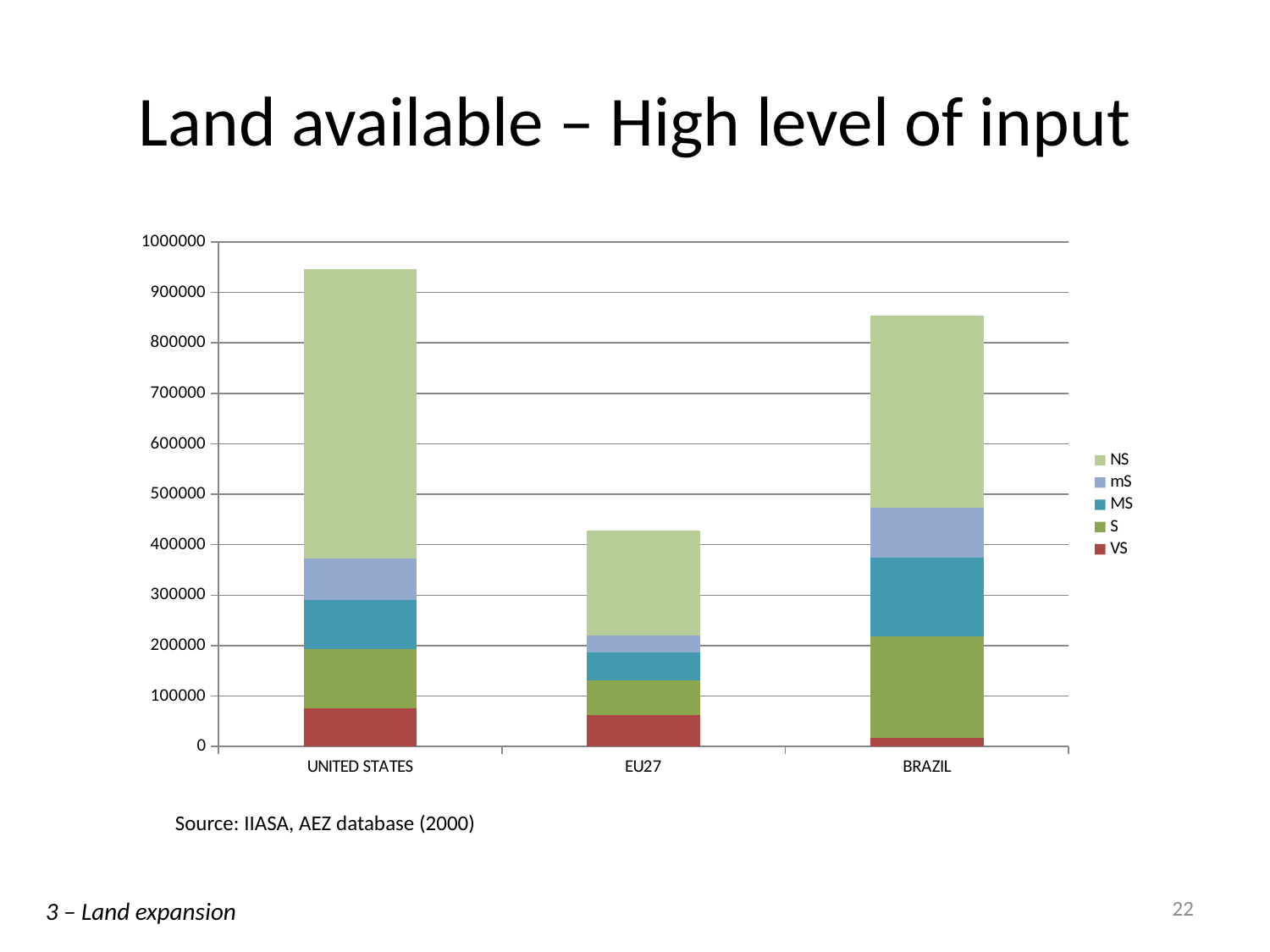
Is the total stacked bar for BRAZIL greater or less than 800000? greater Which country or region has the tallest stacked bar? UNITED STATES Which has the larger MS segment, UNITED STATES or BRAZIL? BRAZIL Which has the larger VS segment, UNITED STATES or BRAZIL? UNITED STATES Is the total stacked bar for EU27 greater or less than 500000? less How many countries or regions are shown on the x axis? 3 How many series does the legend list? 5 Which country or region has the shortest stacked bar? EU27 Is the VS segment for BRAZIL greater or less than 100000? less What is the title of the slide containing the chart? Land available – High level of input What kind of chart is shown on the slide? stacked bar chart